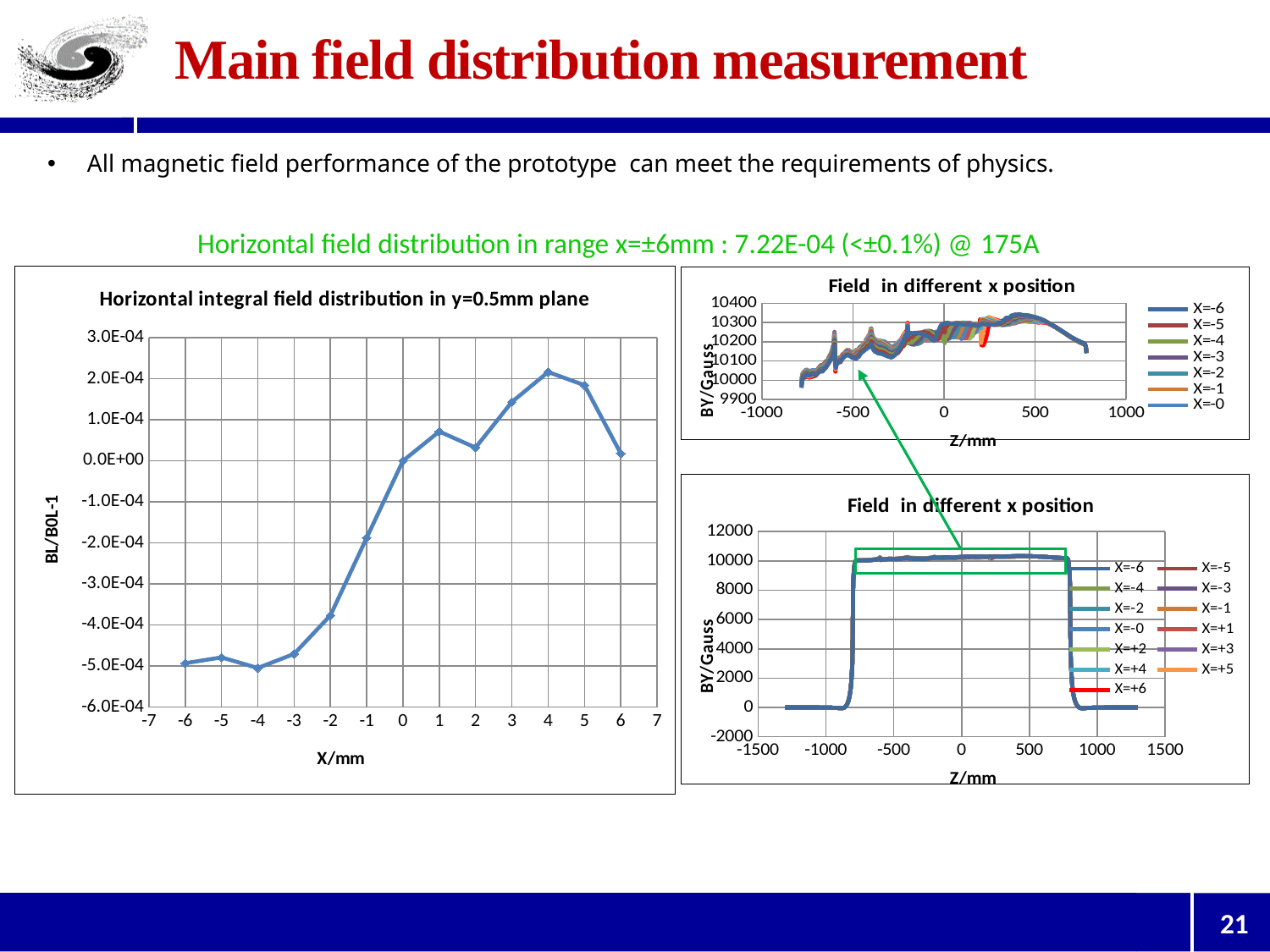
In the 'Horizontal integral field distribution in y=0.5mm plane' chart, at which X/mm value is BL/B0L-1 highest? 4 In the 'Horizontal integral field distribution in y=0.5mm plane' chart, is the value at X=-2 greater or less than -3.0E-04? less In the 'Horizontal integral field distribution in y=0.5mm plane' chart, does BL/B0L-1 rise or fall as X goes from -4 to 4? rise In the 'Horizontal integral field distribution in y=0.5mm plane' chart, is the value at X=3 greater or less than 1.0E-04? greater How many series does the legend of the bottom-right 'Field in different x position' chart list? 13 In the 'Horizontal integral field distribution in y=0.5mm plane' chart, how many data points are plotted? 13 In the 'Horizontal integral field distribution in y=0.5mm plane' chart, at which X/mm value is BL/B0L-1 lowest? -4 What is the y-axis label of the bottom-right 'Field in different x position' chart? BY/Gauss In the 'Horizontal integral field distribution in y=0.5mm plane' chart, is the value at X=-6 greater or less than -4.0E-04? less In the 'Horizontal integral field distribution in y=0.5mm plane' chart, which has the larger BL/B0L-1 value, X=1 or X=2? X=1 What kind of chart is the 'Horizontal integral field distribution in y=0.5mm plane' chart on the left? line chart How many series does the legend of the top-right 'Field in different x position' chart list? 7